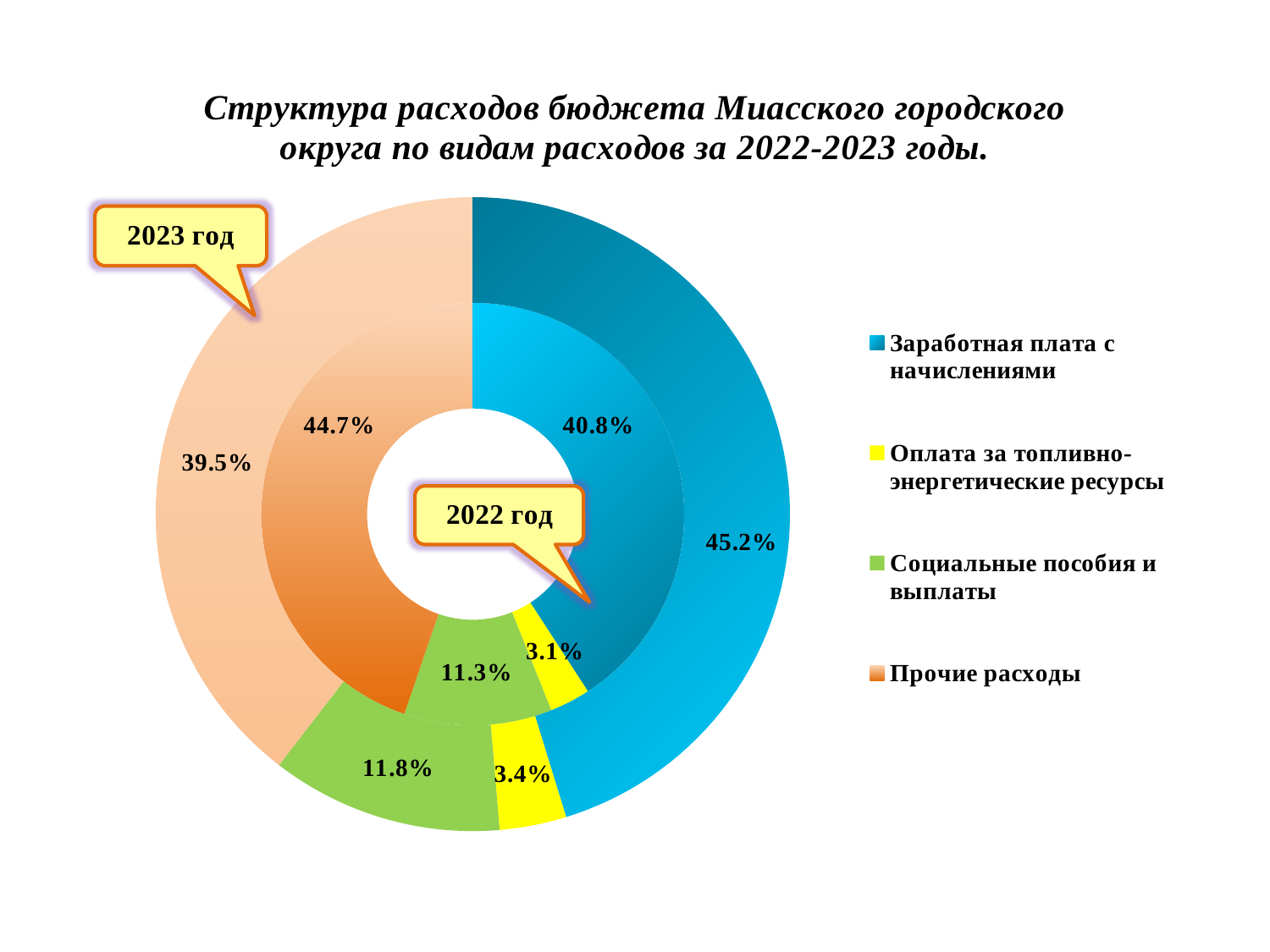
Which category had the largest share in 2023? Заработная плата с начислениями Which category had the smallest share in 2022? Оплата за топливно-энергетические ресурсы What share of expenses was 'Заработная плата с начислениями' in 2023? 45.2% Which was larger in 2022: the share of 'Заработная плата с начислениями' or the share of 'Прочие расходы'? Прочие расходы What share of expenses was 'Заработная плата с начислениями' in 2022? 40.8% Which ring of the doughnut represents 2023: the inner or the outer? Outer What kind of chart is shown on the slide? Doughnut chart What share of expenses was 'Оплата за топливно-энергетические ресурсы' in 2022? 3.1% How many categories does the legend list? 4 What share of expenses was 'Социальные пособия и выплаты' in 2023? 11.8% By how many percentage points did the share of 'Прочие расходы' change from 2022 to 2023? 5.2 percentage points lower What share of expenses was 'Прочие расходы' in 2022? 44.7%